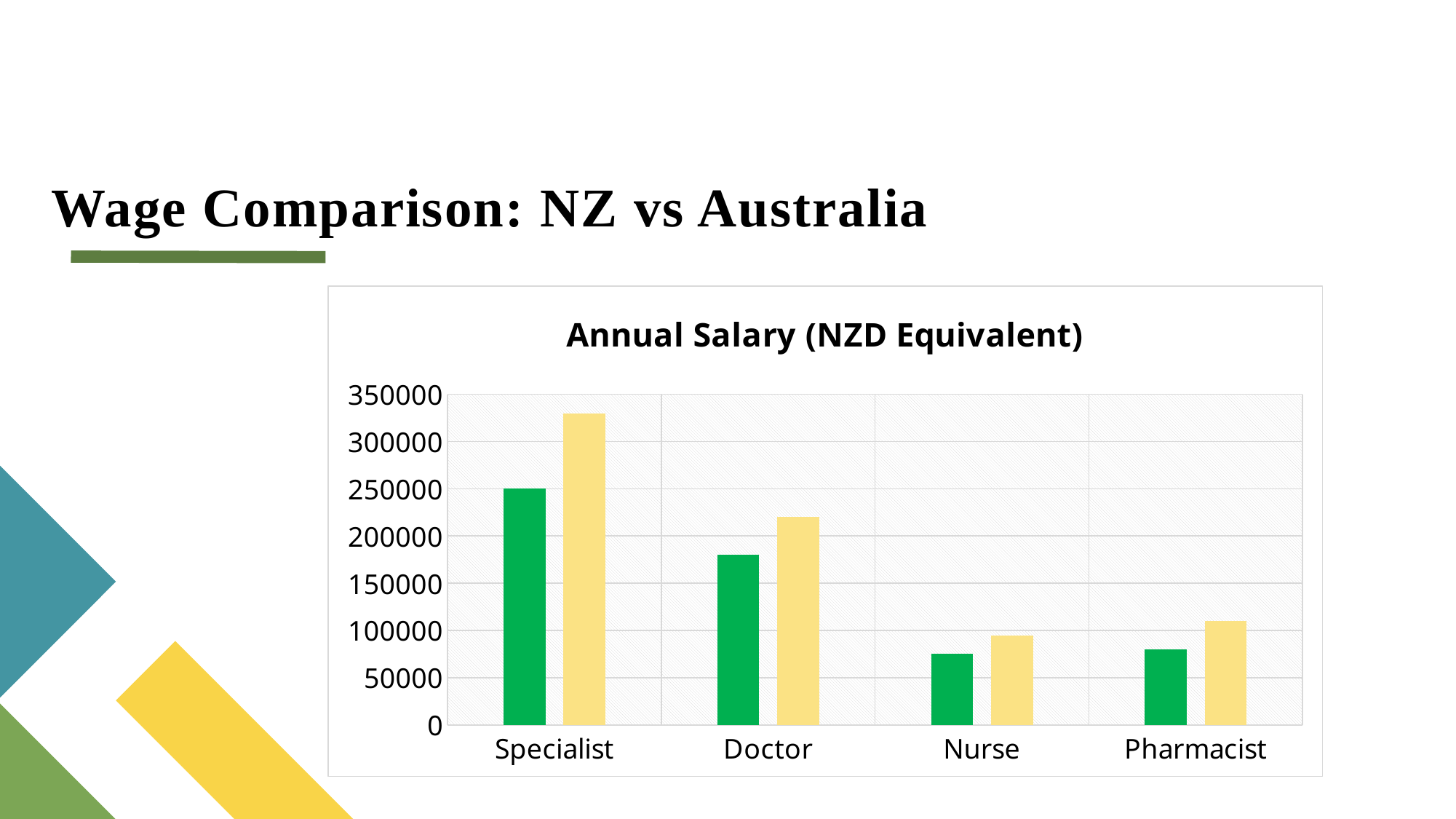
What kind of chart is shown on the slide? bar chart Among the yellow bars, which occupation has the lowest value? Nurse Which is larger, the green bar for Specialist or the green bar for Doctor? Specialist Is the green bar for Doctor greater or less than 150000? greater Is the yellow bar for Pharmacist greater or less than 100000? greater What is the title of the chart? Annual Salary (NZD Equivalent) Is the yellow bar for Specialist greater or less than 300000? greater Which occupation has the highest annual salary in the chart? Specialist What is the value of the green bar for Specialist? 250000 How many occupation categories are shown on the x axis? 4 For Doctor, which bar is larger, the green bar or the yellow bar? the yellow bar